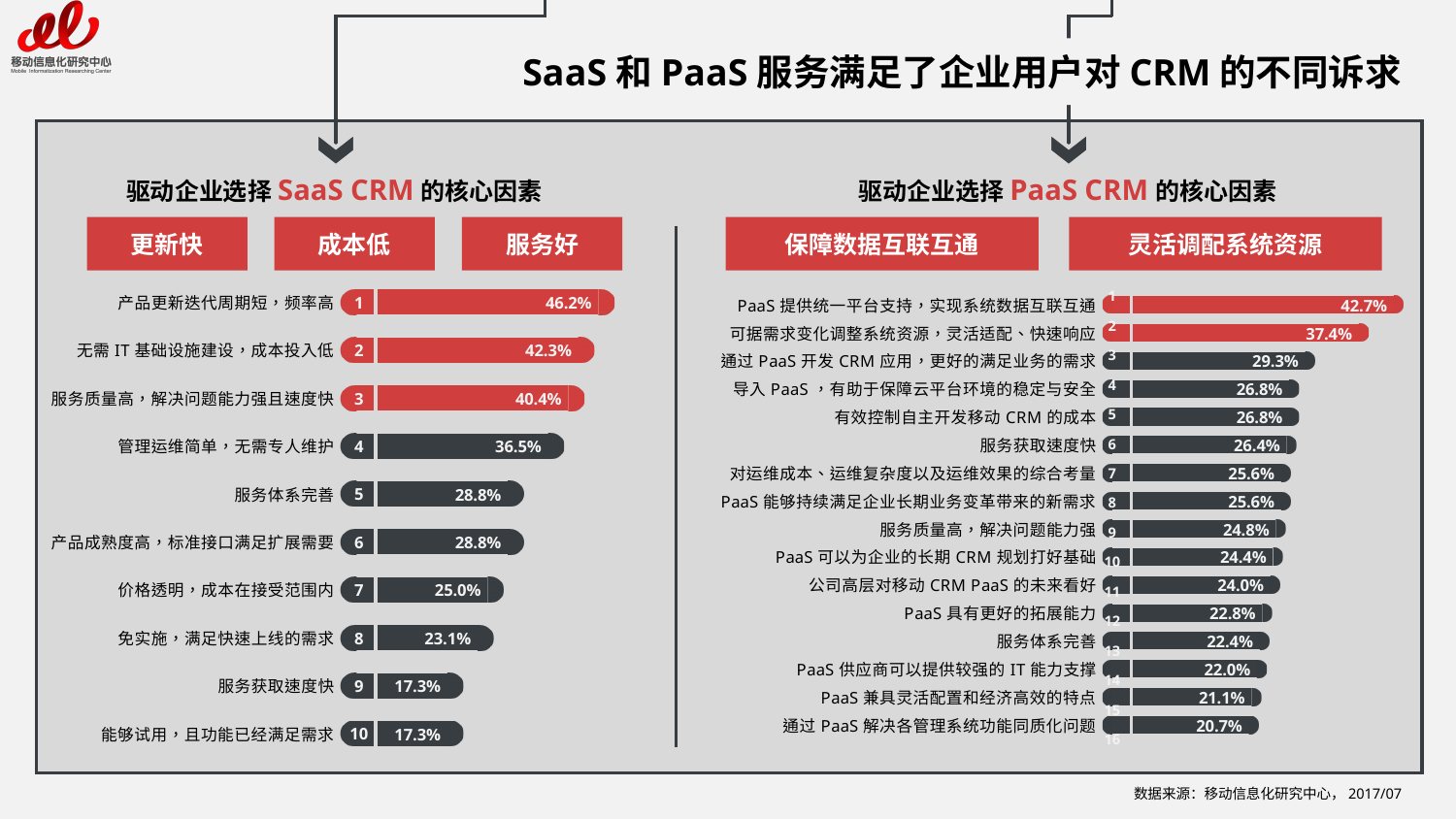
What type of chart is used on the left side of the slide? Bar chart In the left chart (驱动企业选择 SaaS CRM 的核心因素), how many factors are listed? 10 In the right chart (驱动企业选择 PaaS CRM 的核心因素), what is the value for 通过 PaaS 开发 CRM 应用，更好的满足业务的需求? 29.3% In the left chart (驱动企业选择 SaaS CRM 的核心因素), what is the difference between 无需 IT 基础设施建设，成本投入低 and 免实施，满足快速上线的需求? 19.2% In the left chart (驱动企业选择 SaaS CRM 的核心因素), what is the value for 管理运维简单，无需专人维护? 36.5% In the right chart (驱动企业选择 PaaS CRM 的核心因素), what is the difference between 可据需求变化调整系统资源，灵活适配、快速响应 and 服务获取速度快? 11.0% In the right chart (驱动企业选择 PaaS CRM 的核心因素), which factor has the lowest value? 通过 PaaS 解决各管理系统功能同质化问题 In the left chart (驱动企业选择 SaaS CRM 的核心因素), which is larger: 价格透明，成本在接受范围内 or 服务体系完善? 服务体系完善 In the right chart (驱动企业选择 PaaS CRM 的核心因素), how many factors are listed? 16 In the left chart (驱动企业选择 SaaS CRM 的核心因素), what is the value for 产品更新迭代周期短，频率高? 46.2% In the right chart (驱动企业选择 PaaS CRM 的核心因素), what is the value for PaaS 提供统一平台支持，实现系统数据互联互通? 42.7% In the left chart (驱动企业选择 SaaS CRM 的核心因素), which factor has the highest value? 产品更新迭代周期短，频率高